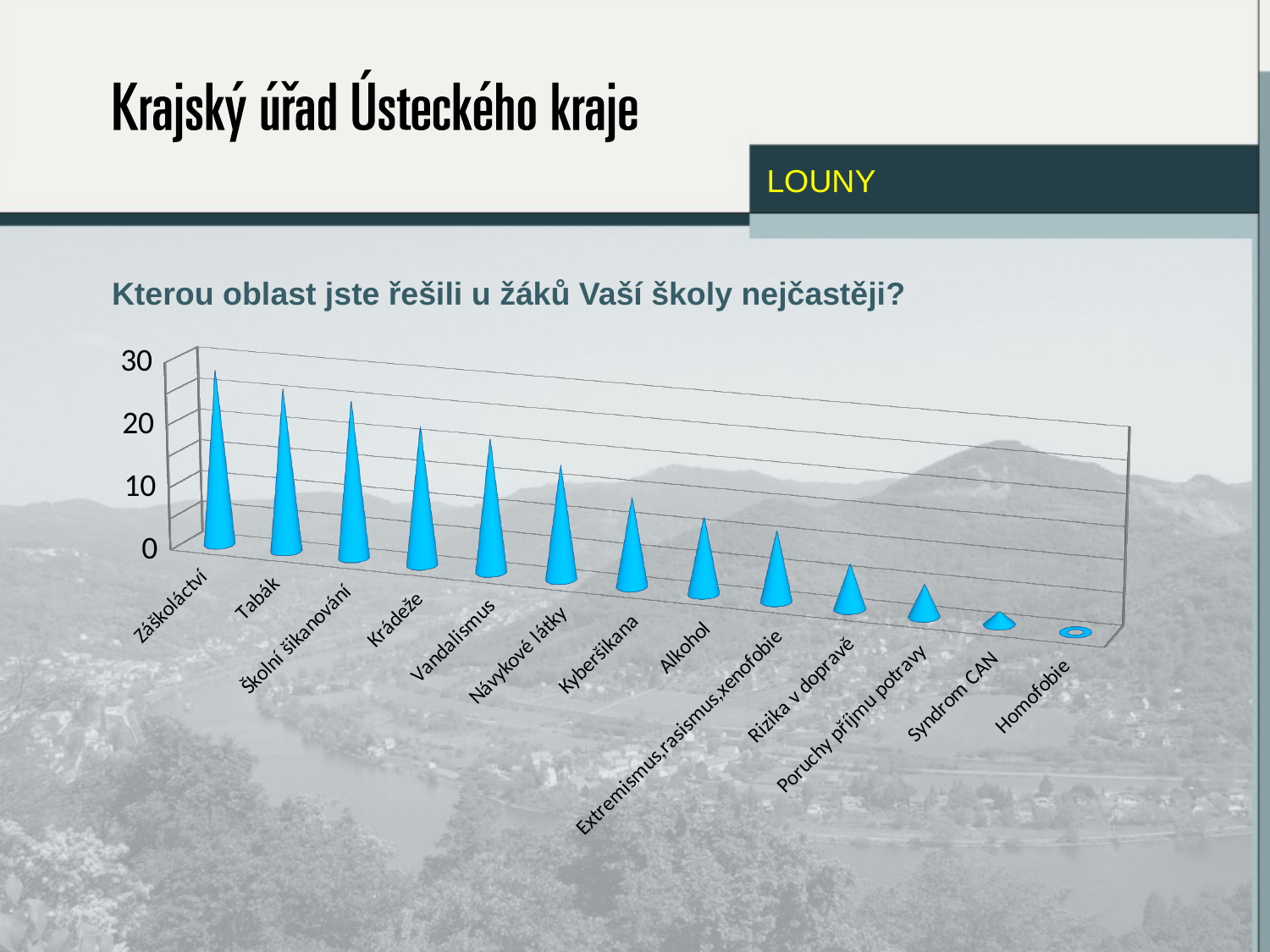
Is the value for Záškoláctví greater or less than 20? greater How many categories are plotted on the chart? 13 Which category has the highest value on the chart? Záškoláctví What question is shown as the title above the chart? Kterou oblast jste řešili u žáků Vaší školy nejčastěji? Which is larger, the value for Kyberšikana or the value for Krádeže? Krádeže Is the value for Návykové látky greater or less than 10? greater What kind of chart is shown on the slide? bar chart Which category has the lowest value on the chart? Homofobie Do the values rise or fall from left to right along the x axis? fall Is the value for Syndrom CAN greater or less than 10? less Which is larger, the value for Tabák or the value for Alkohol? Tabák